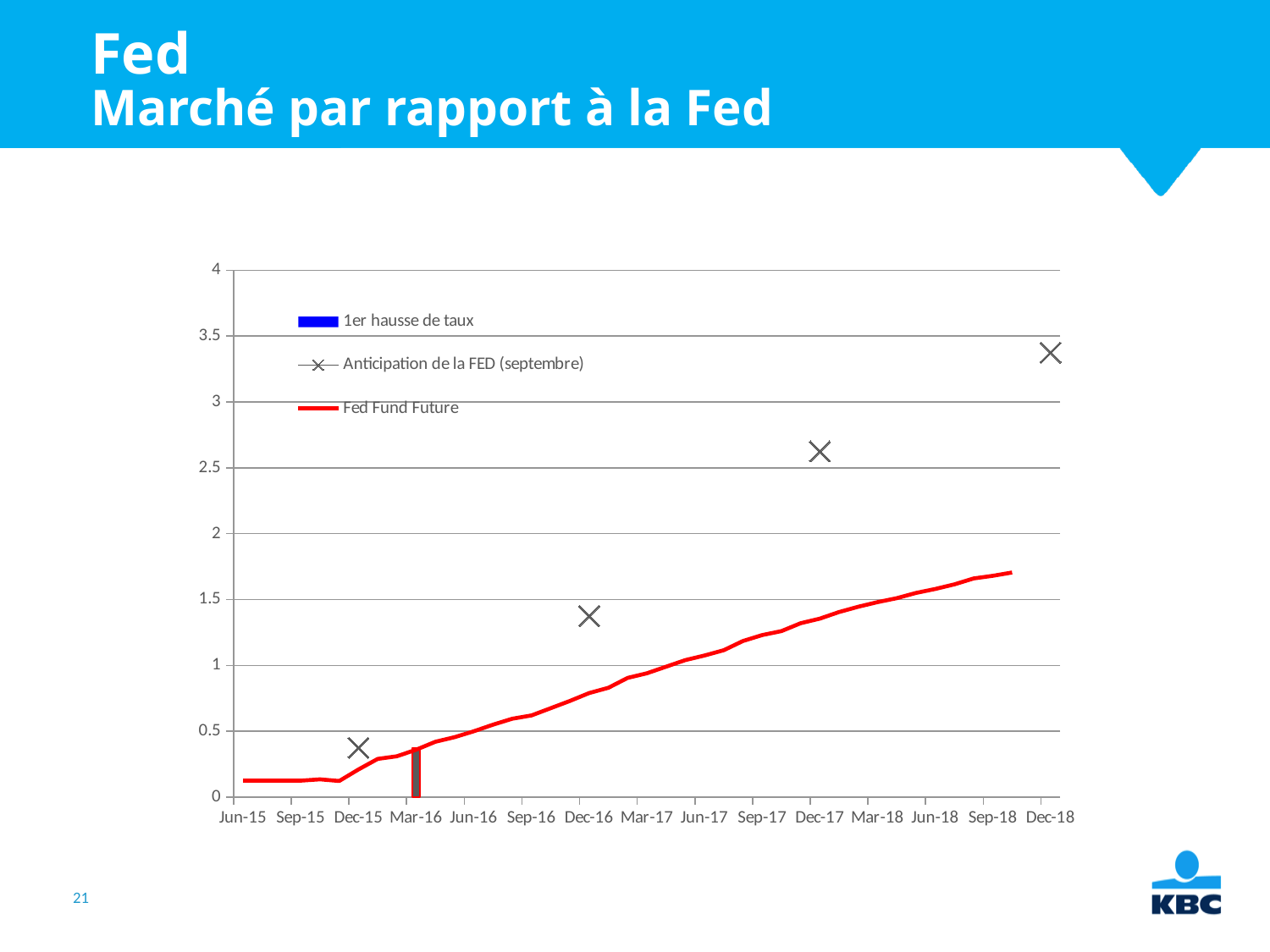
Is the value of Anticipation de la FED (septembre) at Dec-16 greater or less than 1.5? less Is the value of Fed Fund Future at Sep-18 greater or less than 2? less How many X markers for Anticipation de la FED (septembre) are plotted? 4 Near which x-axis label is the blue bar for 1er hausse de taux located? Mar-16 What is the legend label of the blue bar series? 1er hausse de taux What kind of chart is shown on the slide? combination bar and line chart How many series does the legend list? 3 At Dec-17, which is higher: Anticipation de la FED (septembre) or Fed Fund Future? Anticipation de la FED (septembre) Is the value of Anticipation de la FED (septembre) at Dec-18 greater or less than 3? greater Does the Fed Fund Future line rise or fall from Jun-15 to Sep-18? rise